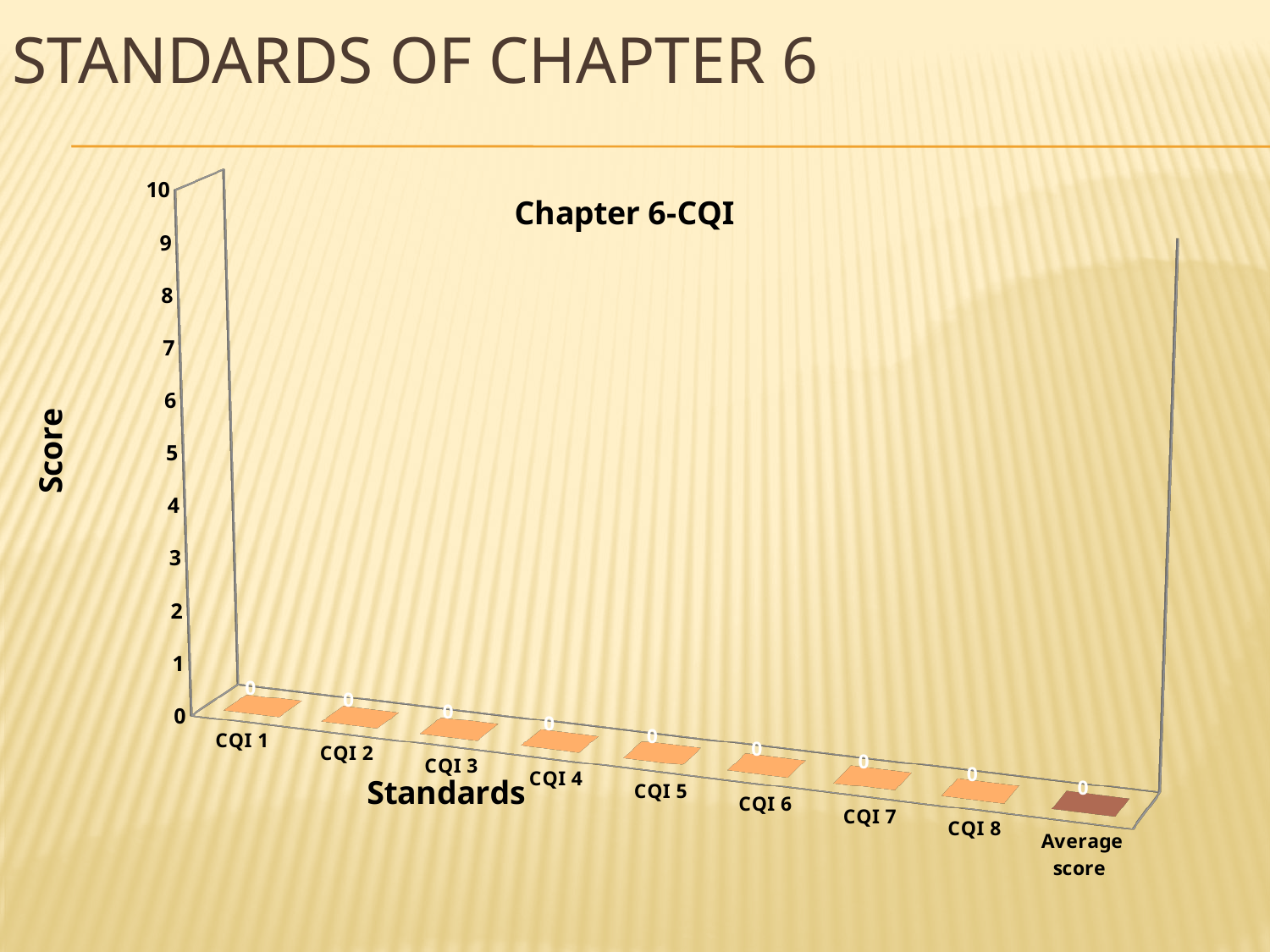
Is the value for CQI 3 greater or less than 5? less What is the value for Average score in the Chapter 6-CQI chart? 0 What kind of chart is the Chapter 6-CQI chart? bar chart What is the title of the chart? Chapter 6-CQI What is the label on the vertical axis of the chart? Score What is the highest value shown on the vertical axis of the chart? 10 What is the value for CQI 5 in the Chapter 6-CQI chart? 0 Do the values rise, fall, or stay flat from CQI 1 to CQI 8? stay flat How many categories are shown on the x axis of the Chapter 6-CQI chart? 9 What is the value for CQI 1 in the Chapter 6-CQI chart? 0 What is the value for CQI 8 in the Chapter 6-CQI chart? 0 What is the difference between the values for CQI 2 and CQI 7? 0